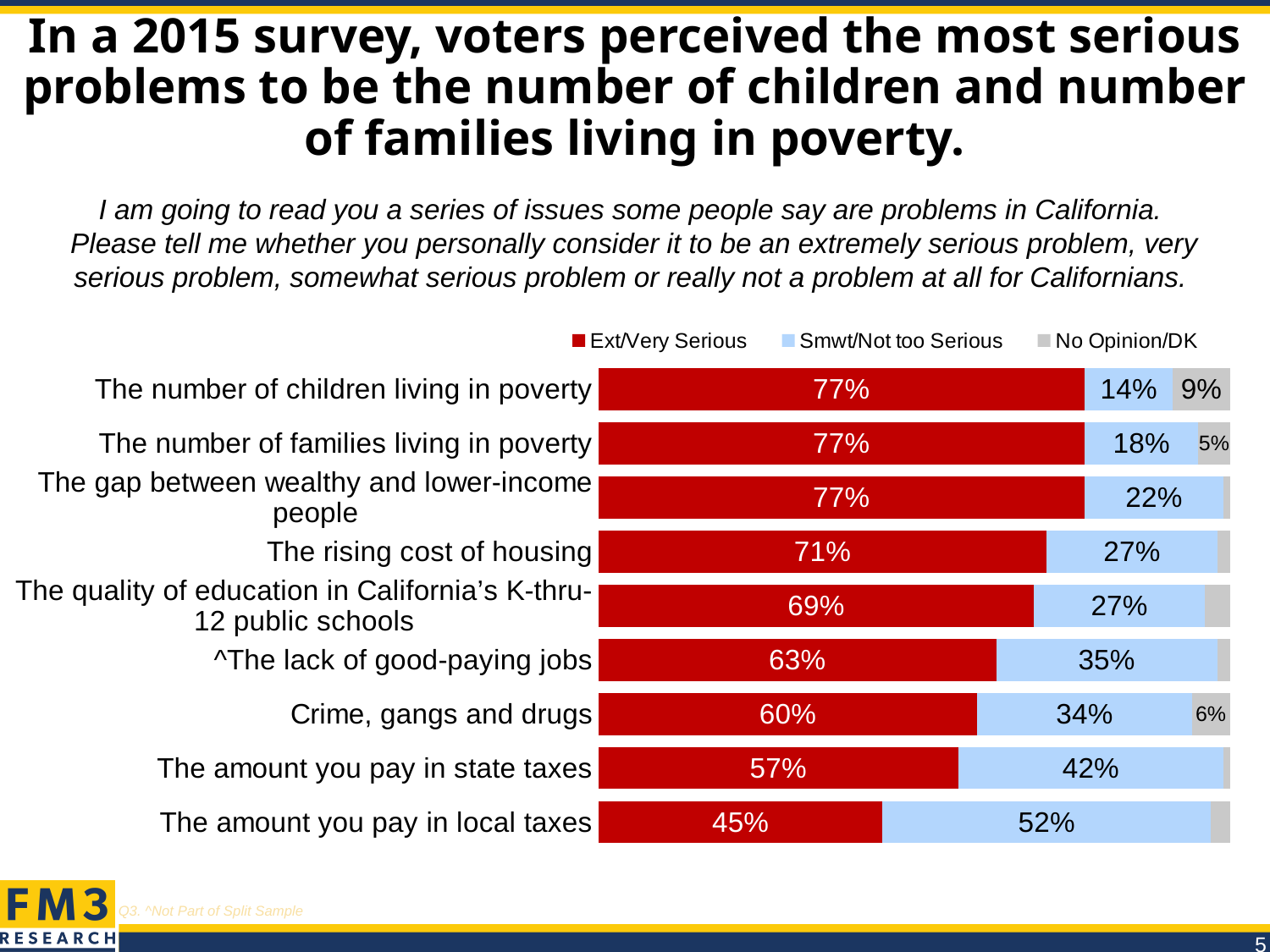
What is the difference in Ext/Very Serious percentage between the amount you pay in state taxes and the amount you pay in local taxes? 12 percentage points What type of chart is shown on the slide? Stacked bar chart What is the Smwt/Not too Serious value for the amount you pay in state taxes? 42% Which issue has the lowest Ext/Very Serious percentage? The amount you pay in local taxes How many issues are listed in the chart? 9 What colour represents the Ext/Very Serious series? Red Which has a higher Ext/Very Serious percentage: the lack of good-paying jobs or crime, gangs and drugs? The lack of good-paying jobs How many series does the legend list? 3 What is the total of the three segments for the number of children living in poverty? 100% Which issue has the highest Smwt/Not too Serious percentage? The amount you pay in local taxes What is the No Opinion/DK value for crime, gangs and drugs? 6% What percentage of voters rated the rising cost of housing as Ext/Very Serious? 71%